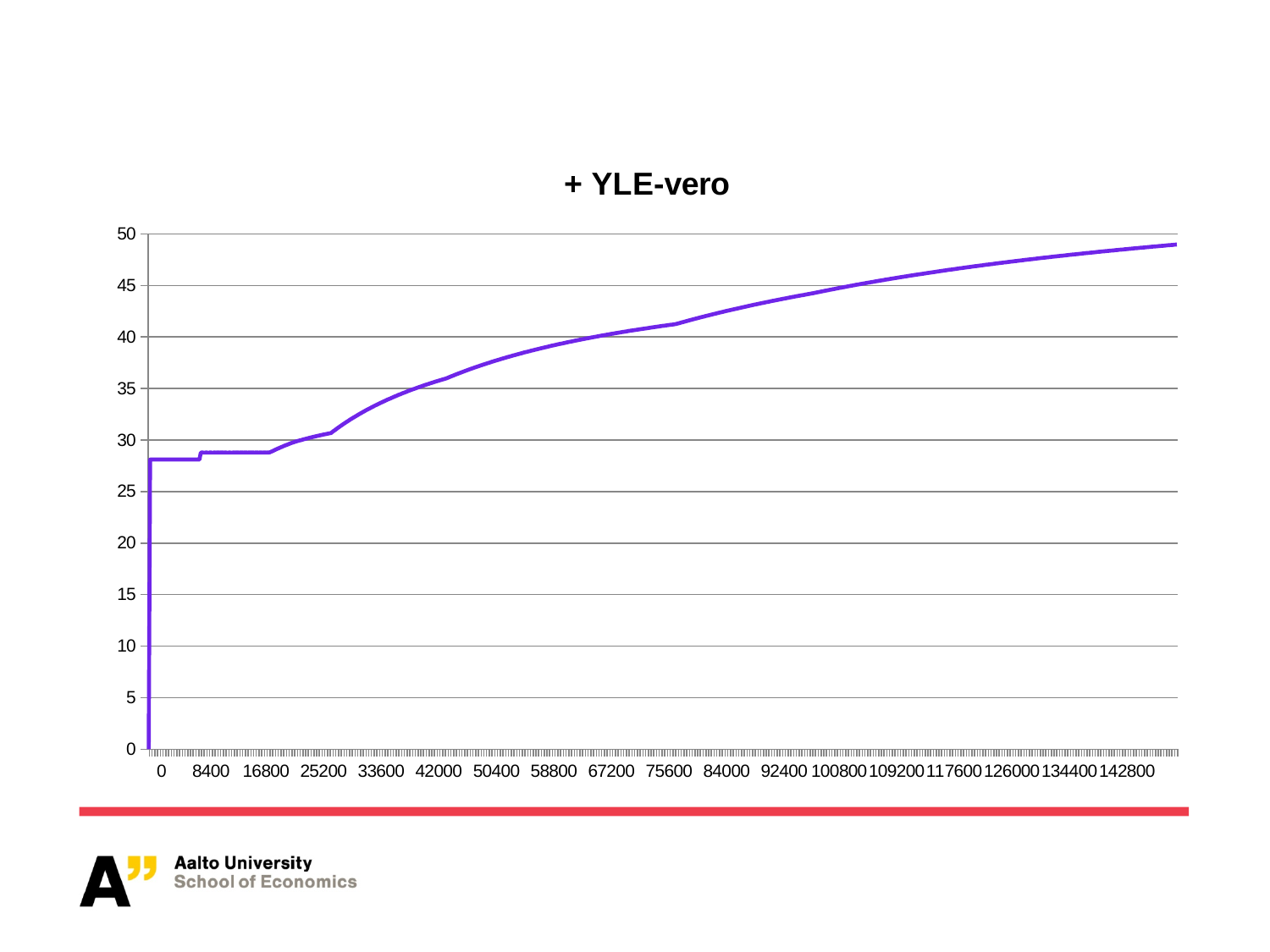
Is the value at x = 8400 greater or less than 30? less Is the value at x = 142800 greater or less than 50? less What is the title of the chart? + YLE-vero Is the value at x = 84000 greater or less than 40? greater Which is larger, the value at x = 84000 or the value at x = 8400? x = 84000 Do the values generally rise or fall as you move from left to right along the x axis? rise What kind of chart is shown on the slide? line chart What is the highest value shown on the y axis? 50